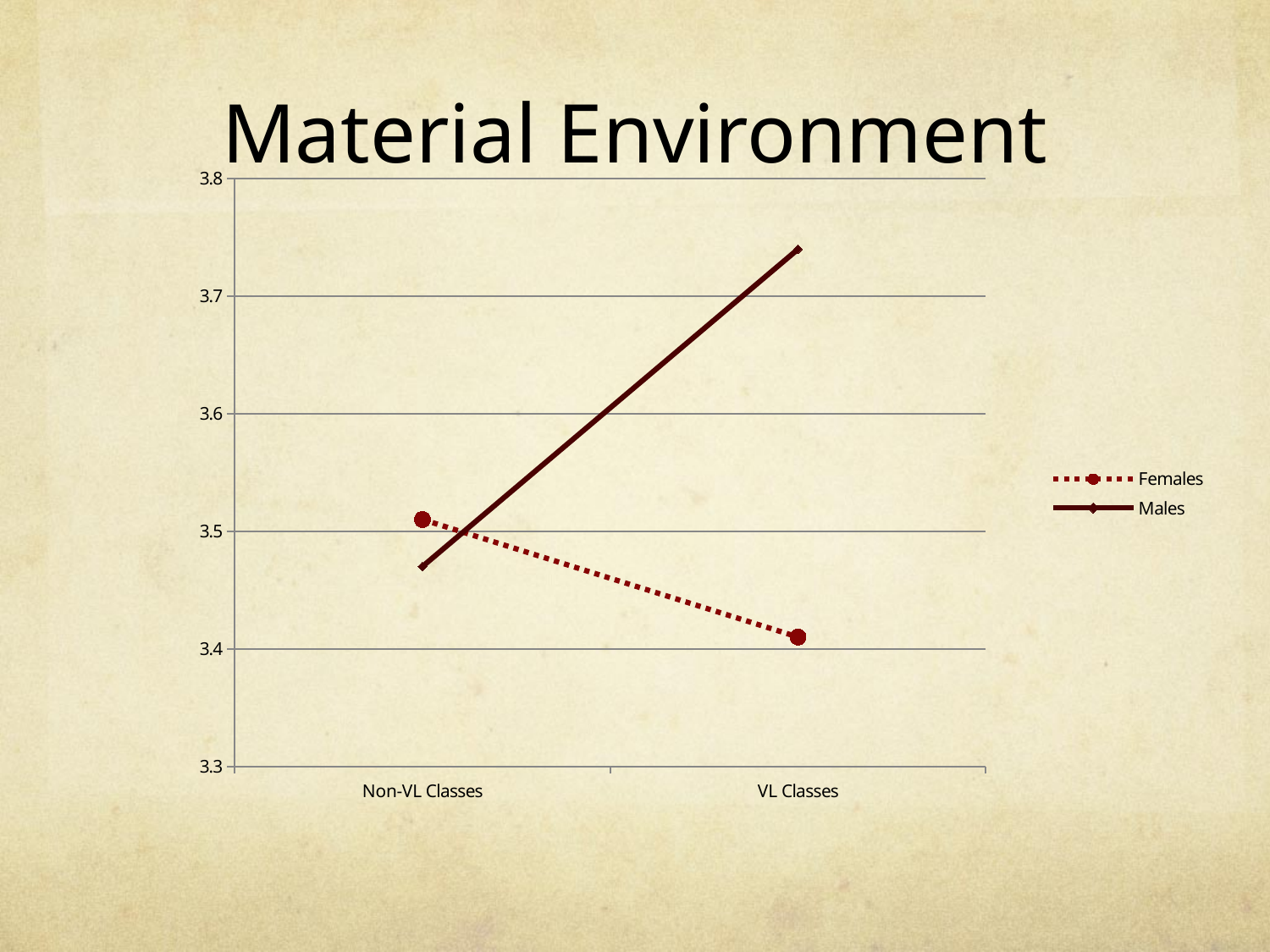
Is the value for Males at VL Classes greater or less than 3.7? greater Is the value for Males at Non-VL Classes greater or less than 3.5? less Which series and category has the highest value on the chart? Males at VL Classes Which series is drawn with a dotted line? Females Do the values for Females rise or fall from Non-VL Classes to VL Classes? fall What kind of chart is shown on the slide? line chart What is the title of the chart? Material Environment How many series does the legend list? 2 Is the value for Females at VL Classes greater or less than 3.5? less Do the values for Males rise or fall from Non-VL Classes to VL Classes? rise At VL Classes, which series has the larger value, Females or Males? Males How many categories are shown on the x axis? 2